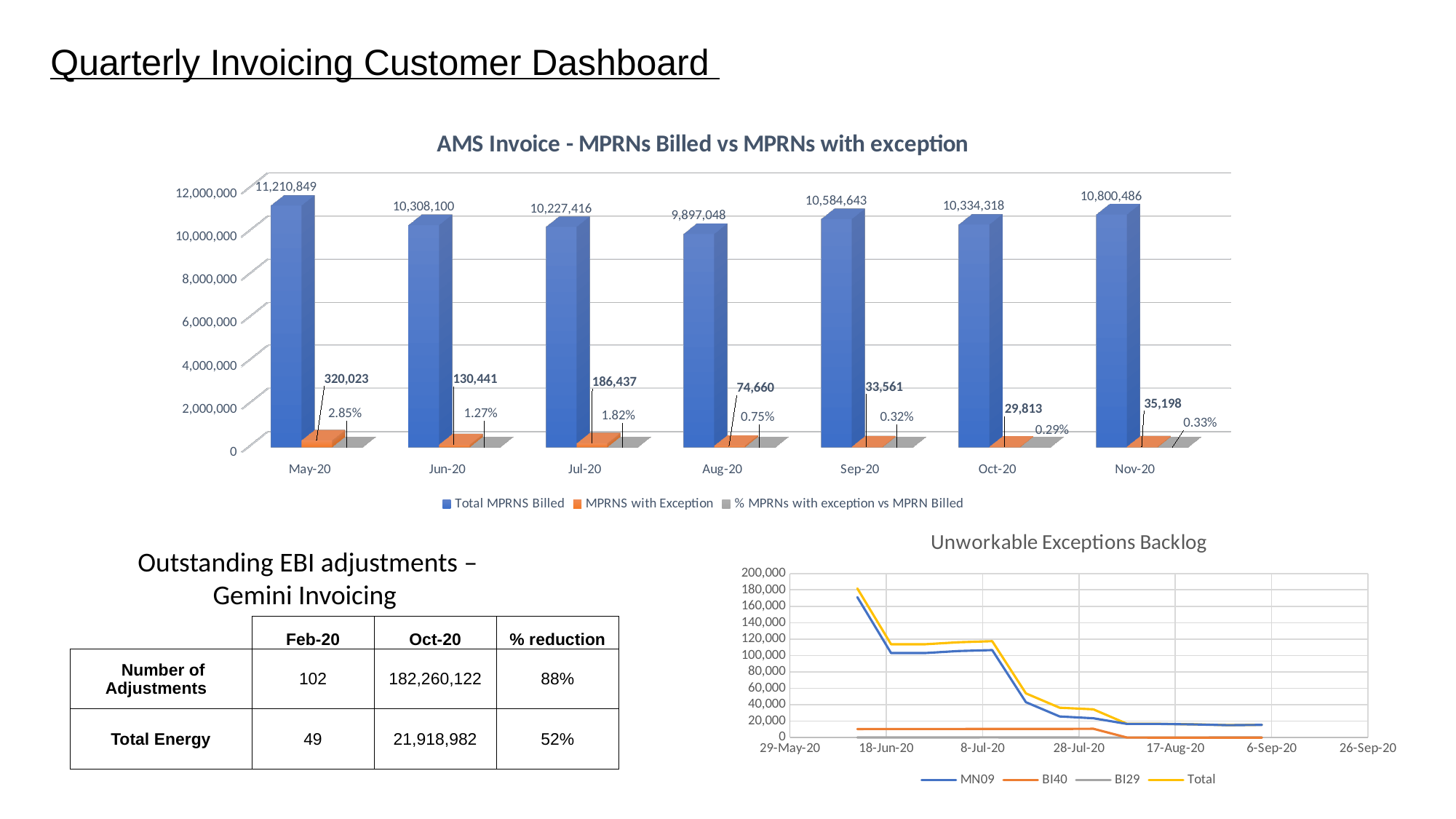
In the AMS Invoice - MPRNs Billed vs MPRNs with exception chart, how many series does the legend list? 3 What kind of chart is the Unworkable Exceptions Backlog chart? Line chart In the AMS Invoice - MPRNs Billed vs MPRNs with exception chart, which month has the highest Total MPRNS Billed? May-20 In the AMS Invoice - MPRNs Billed vs MPRNs with exception chart, which month has the lowest Total MPRNS Billed? Aug-20 In the AMS Invoice - MPRNs Billed vs MPRNs with exception chart, which month has the lowest number of MPRNS with Exception? Oct-20 In the Unworkable Exceptions Backlog chart, does the Total series rise or fall over time? Fall In the AMS Invoice - MPRNs Billed vs MPRNs with exception chart, what is the Total MPRNS Billed value for May-20? 11,210,849 In the AMS Invoice - MPRNs Billed vs MPRNs with exception chart, how many MPRNS with Exception are shown for Aug-20? 74,660 In the AMS Invoice - MPRNs Billed vs MPRNs with exception chart, what is the difference between Total MPRNS Billed in May-20 and Jun-20? 902,749 In the AMS Invoice - MPRNs Billed vs MPRNs with exception chart, how many months are shown on the x axis? 7 In the AMS Invoice - MPRNs Billed vs MPRNs with exception chart, what is the % MPRNs with exception vs MPRN Billed for Nov-20? 0.33% In the AMS Invoice - MPRNs Billed vs MPRNs with exception chart, which month has more MPRNS with Exception, Jun-20 or Jul-20? Jul-20